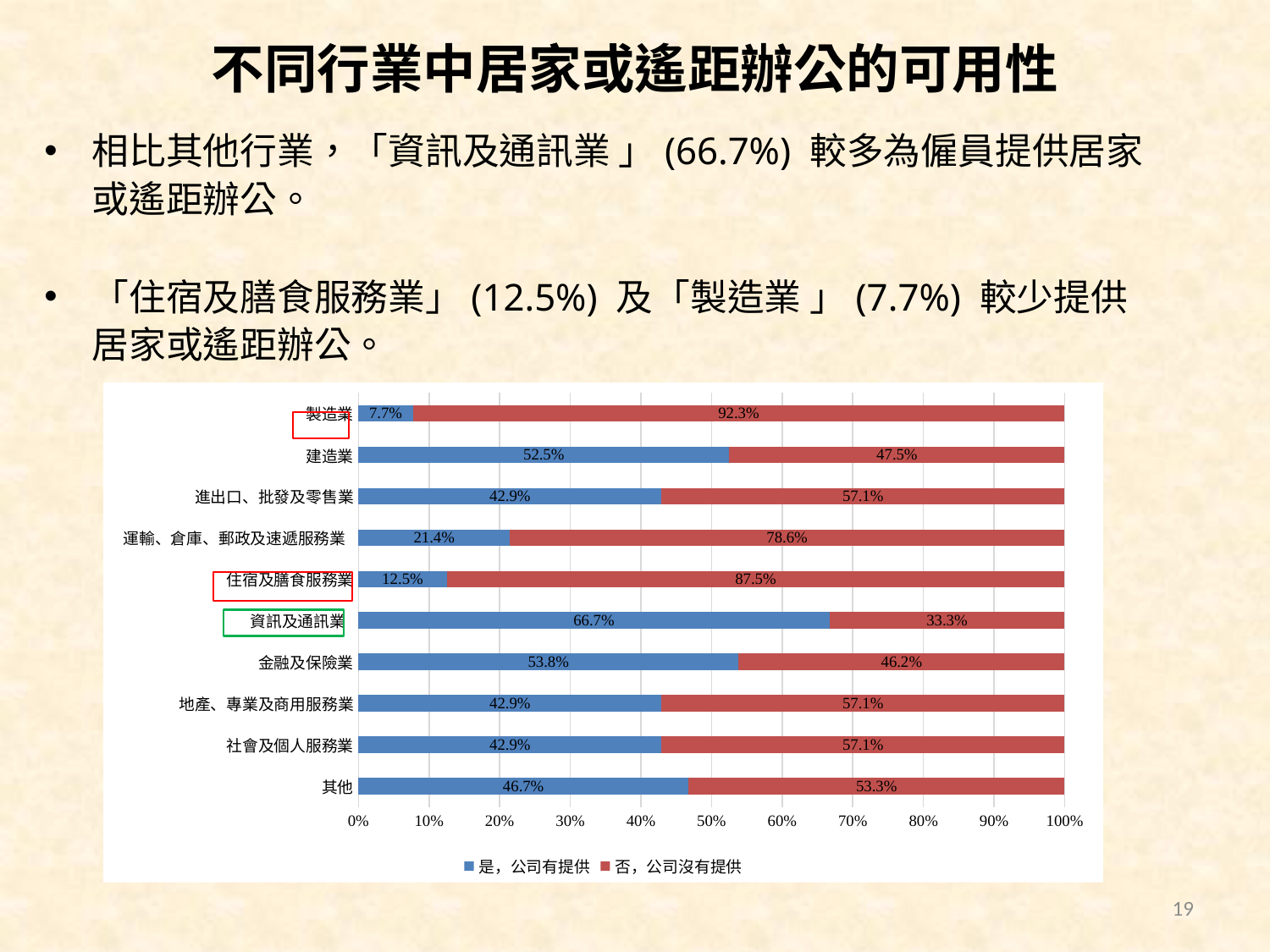
How many industry categories are plotted in the chart? 10 What is the value of 是，公司有提供 for 運輸、倉庫、郵政及速遞服務業? 21.4% What is the total of the two segments in the bar for 地產、專業及商用服務業? 100% What is the value of 是，公司有提供 for 資訊及通訊業? 66.7% What is the value of 否，公司沒有提供 for 製造業? 92.3% What is the difference between the 是，公司有提供 values for 建造業 and 住宿及膳食服務業? 40.0% What kind of chart is shown on the slide? Stacked bar chart Which industry has the lowest value for 是，公司有提供? 製造業 Which series is shown in blue in the legend? 是，公司有提供 Which industry has the highest value for 是，公司有提供? 資訊及通訊業 How many series does the legend list? 2 Which is larger: the 是，公司有提供 value for 金融及保險業 or for 其他? 金融及保險業